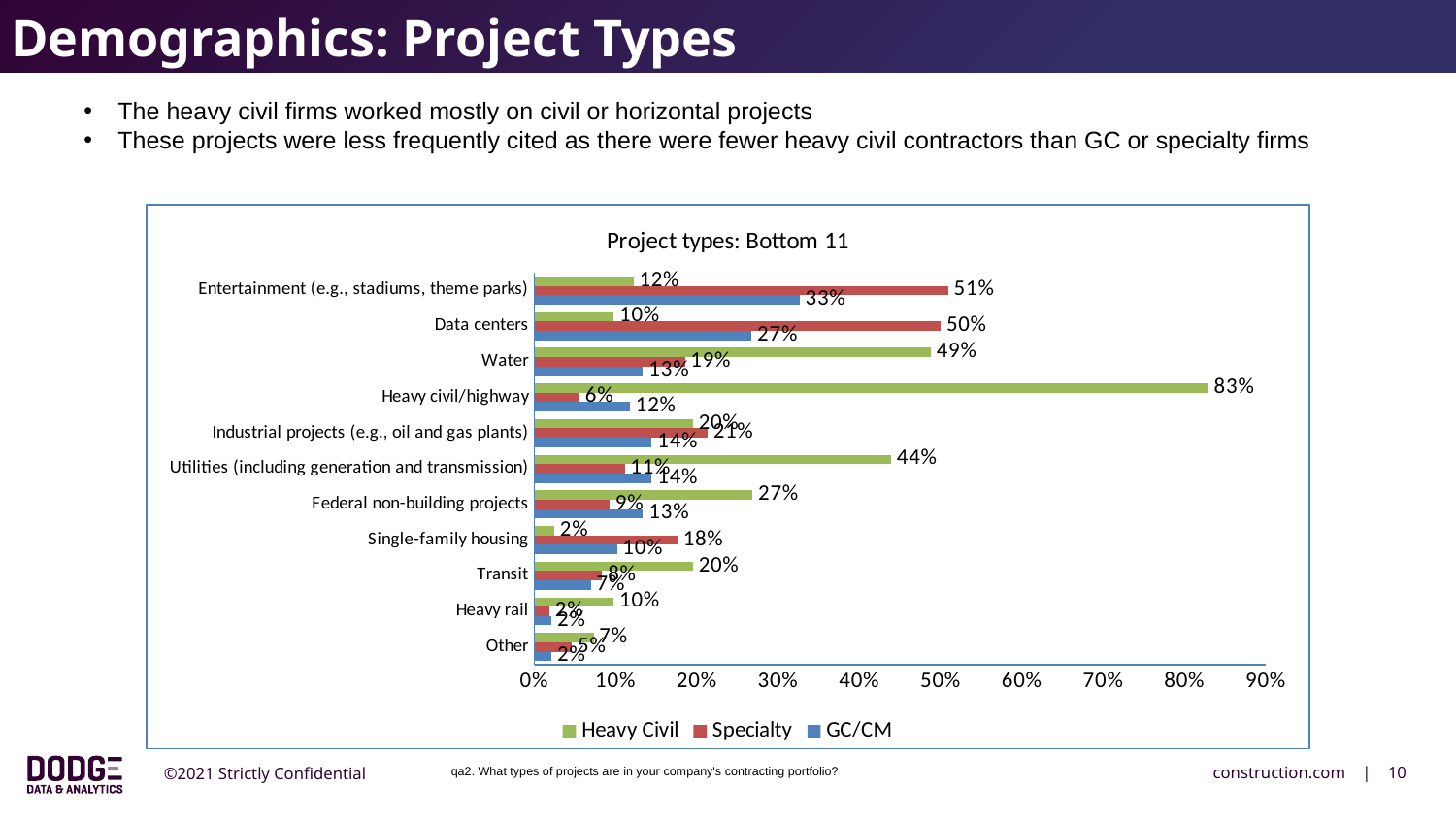
What is the Heavy Civil value for Water? 49% How many series does the legend list? 3 Which project type has the highest Heavy Civil value? Heavy civil/highway Is the Heavy Civil value for Utilities (including generation and transmission) greater or less than 40%? greater What is the Heavy Civil value for Heavy civil/highway? 83% What type of chart is shown on the slide? Bar chart For Entertainment (e.g., stadiums, theme parks), what is the difference between the Specialty value and the Heavy Civil value? 39 percentage points How many project types are shown in the chart? 11 What is the Specialty value for Entertainment (e.g., stadiums, theme parks)? 51% Which project type has the lowest Heavy Civil value? Single-family housing What is the GC/CM value for Data centers? 27% For Water, which series has the larger value, Heavy Civil or Specialty? Heavy Civil